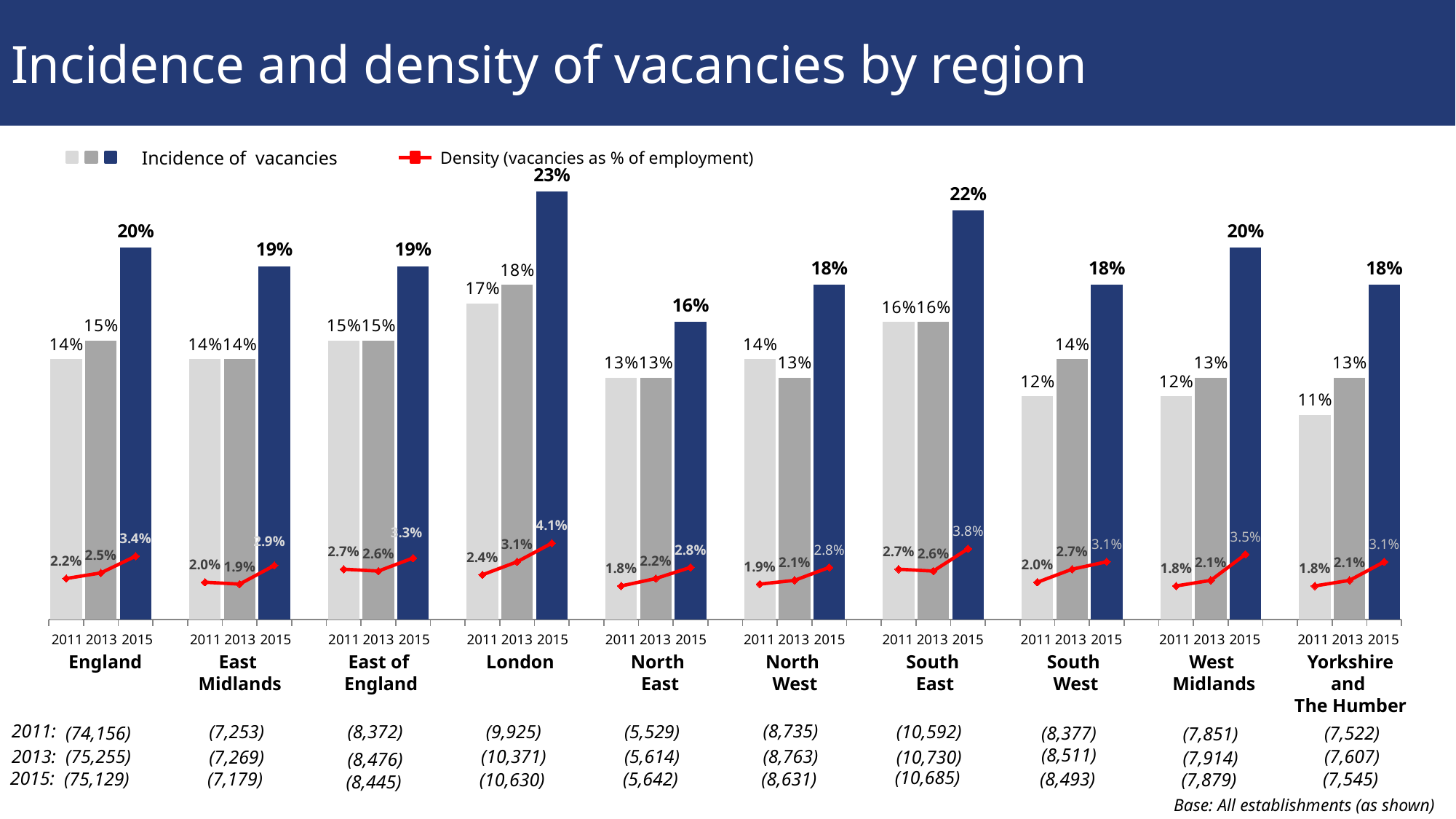
What kind of chart is shown on the slide? Combined bar and line chart What is the incidence of vacancies in London in 2015? 23% What is the incidence of vacancies in Yorkshire and The Humber in 2011? 11% Which region has the lowest incidence of vacancies in 2011? Yorkshire and The Humber What is the density of vacancies (as % of employment) in the South East in 2015? 3.8% Which region has the highest incidence of vacancies in 2015? London By how many percentage points did the incidence of vacancies in the West Midlands rise between 2013 and 2015? 7 percentage points What colour is the line showing density of vacancies? Red How many series does the legend list? 2 How many regions (including England) are shown on the chart? 10 Which is higher: the 2015 density of vacancies in London or in England overall? London How does the density of vacancies in the North East change from 2011 to 2015? It rises